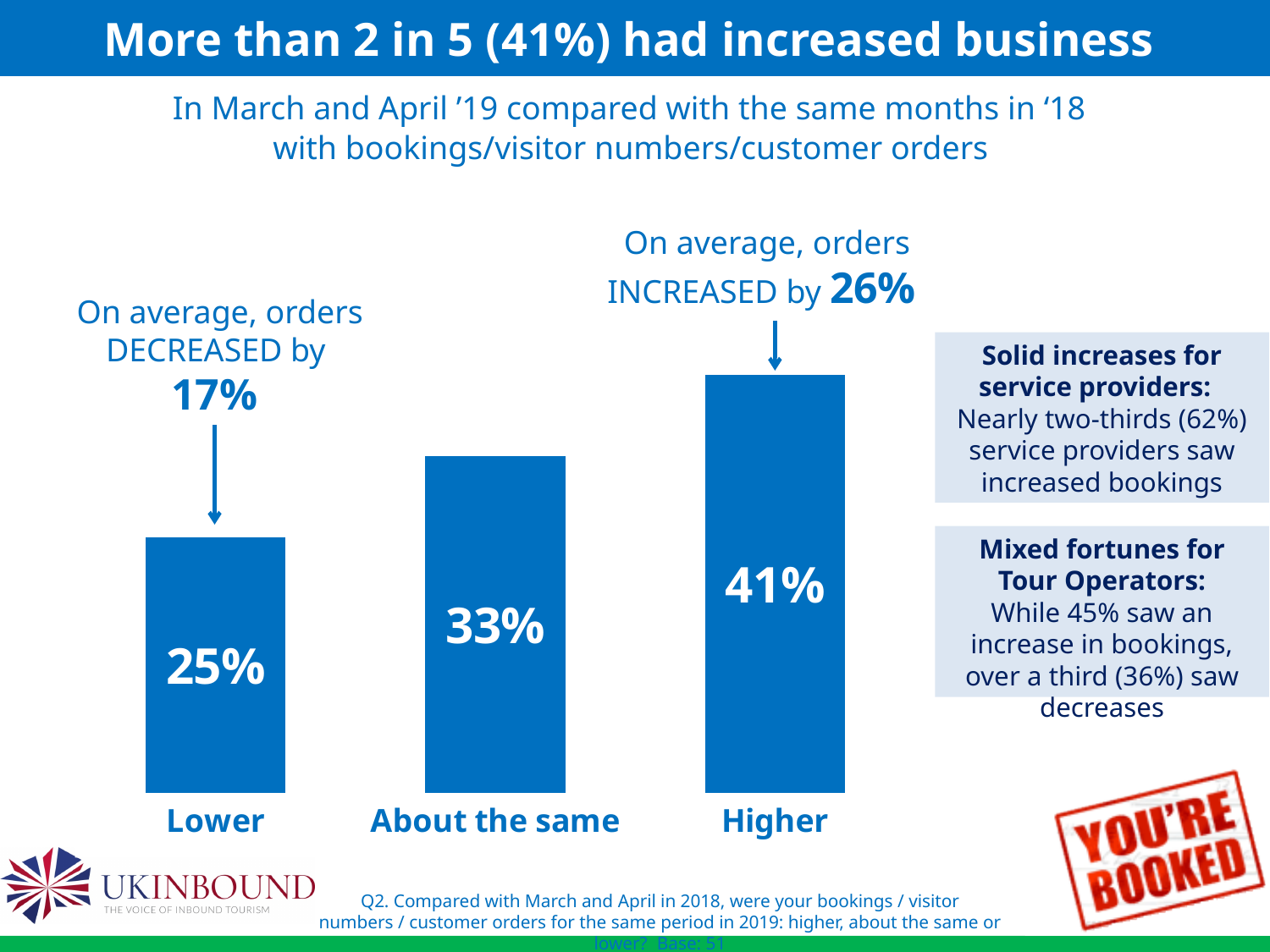
Which category has the highest value? Higher According to the annotation above the 'Higher' bar, by what percentage did orders increase on average? 26% What is the difference between the 'About the same' and 'Lower' values? 8% Which category has the lowest value? Lower What kind of chart is shown on the slide? Bar chart What is the value for the 'Lower' category? 25% Which is larger, the value for 'About the same' or the value for 'Higher'? Higher What is the difference between the 'Higher' and 'Lower' values? 16% What is the value for the 'About the same' category? 33% What is the value for the 'Higher' category? 41% How many categories are shown in the chart? 3 Do the values rise or fall moving from 'Lower' to 'Higher' along the x axis? Rise